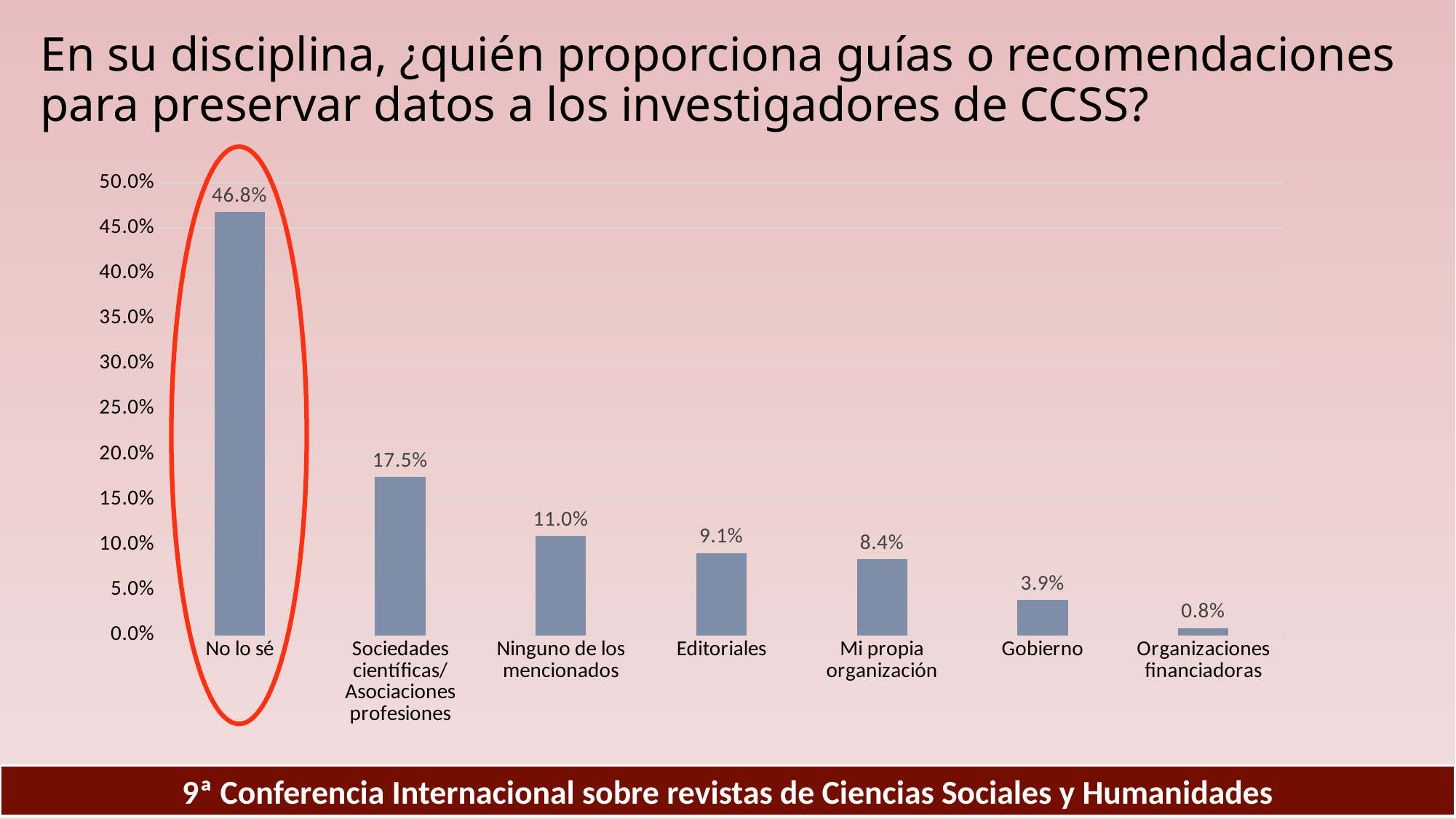
Which is larger, the value for "Mi propia organización" or the value for "Gobierno"? Mi propia organización Which bar is circled in red on the slide? No lo sé What is the difference between the values for "Ninguno de los mencionados" and "Editoriales"? 1.9% What is the value for "Editoriales"? 9.1% How many categories are shown in the chart? 7 Which category has the lowest value? Organizaciones financiadoras What is the value for "Gobierno"? 3.9% What is the value for "No lo sé"? 46.8% What kind of chart is shown on the slide? Bar chart What is the difference between the values for "No lo sé" and "Sociedades científicas/Asociaciones profesiones"? 29.3% Which category has the highest value? No lo sé What is the value for "Organizaciones financiadoras"? 0.8%